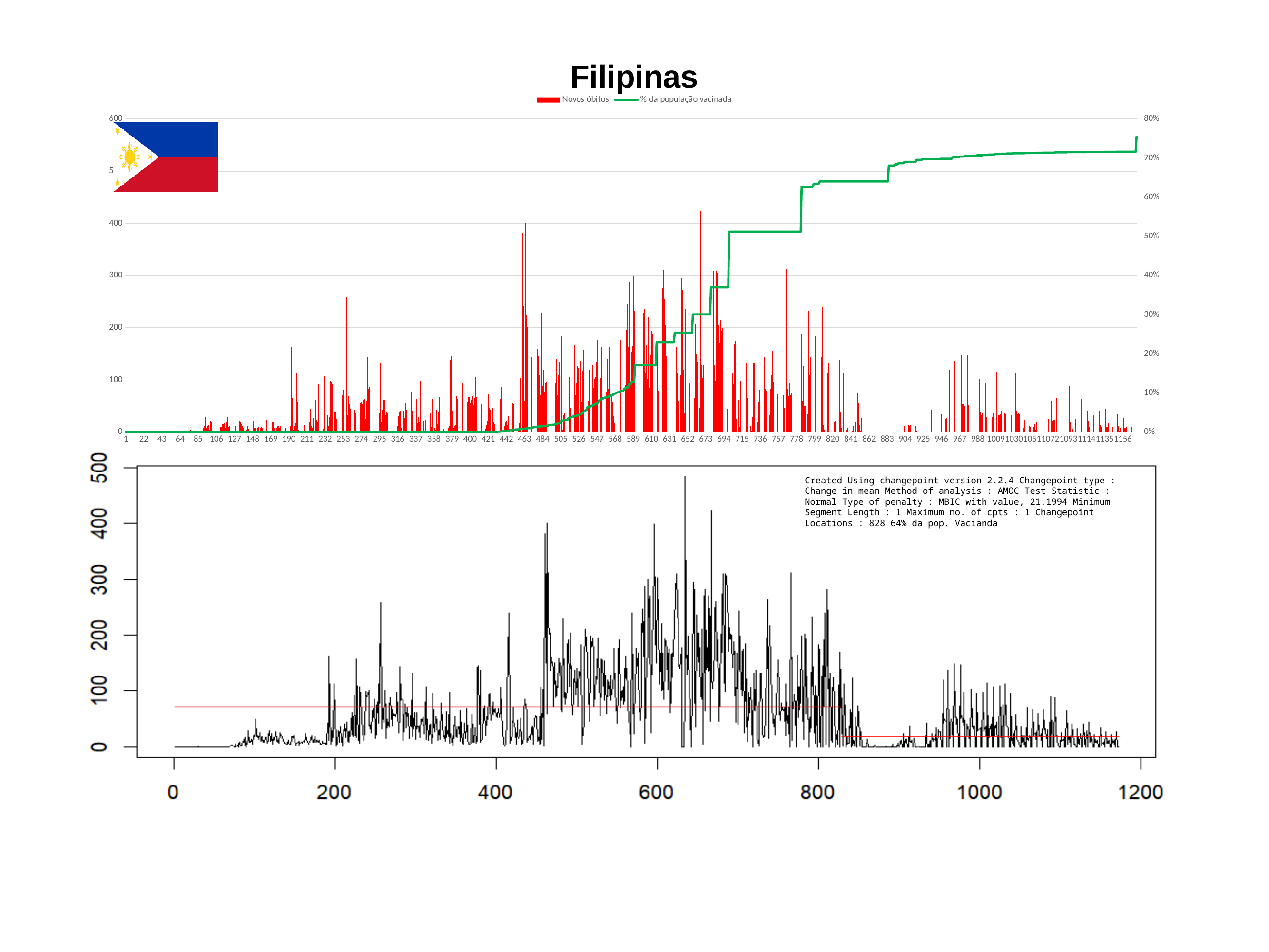
According to the text in the bottom chart, what is the changepoint location? 828 In the top chart, does the % da população vacinada line rise or fall along the x axis? rise In the bottom chart, is the highest peak of the black line greater or less than 400? greater In the top chart, is the value of % da população vacinada at day 800 greater or less than 50%? greater What is the highest tick shown on the right-hand axis of the top chart? 80% In the top chart, is the value of % da população vacinada at day 1156 greater or less than 70%? greater In the top chart, what kind of chart is used to plot the series Novos óbitos? bar chart What is the title of the top chart? Filipinas In the top chart, which series is drawn as a green line? % da população vacinada How many series does the legend of the top chart list? 2